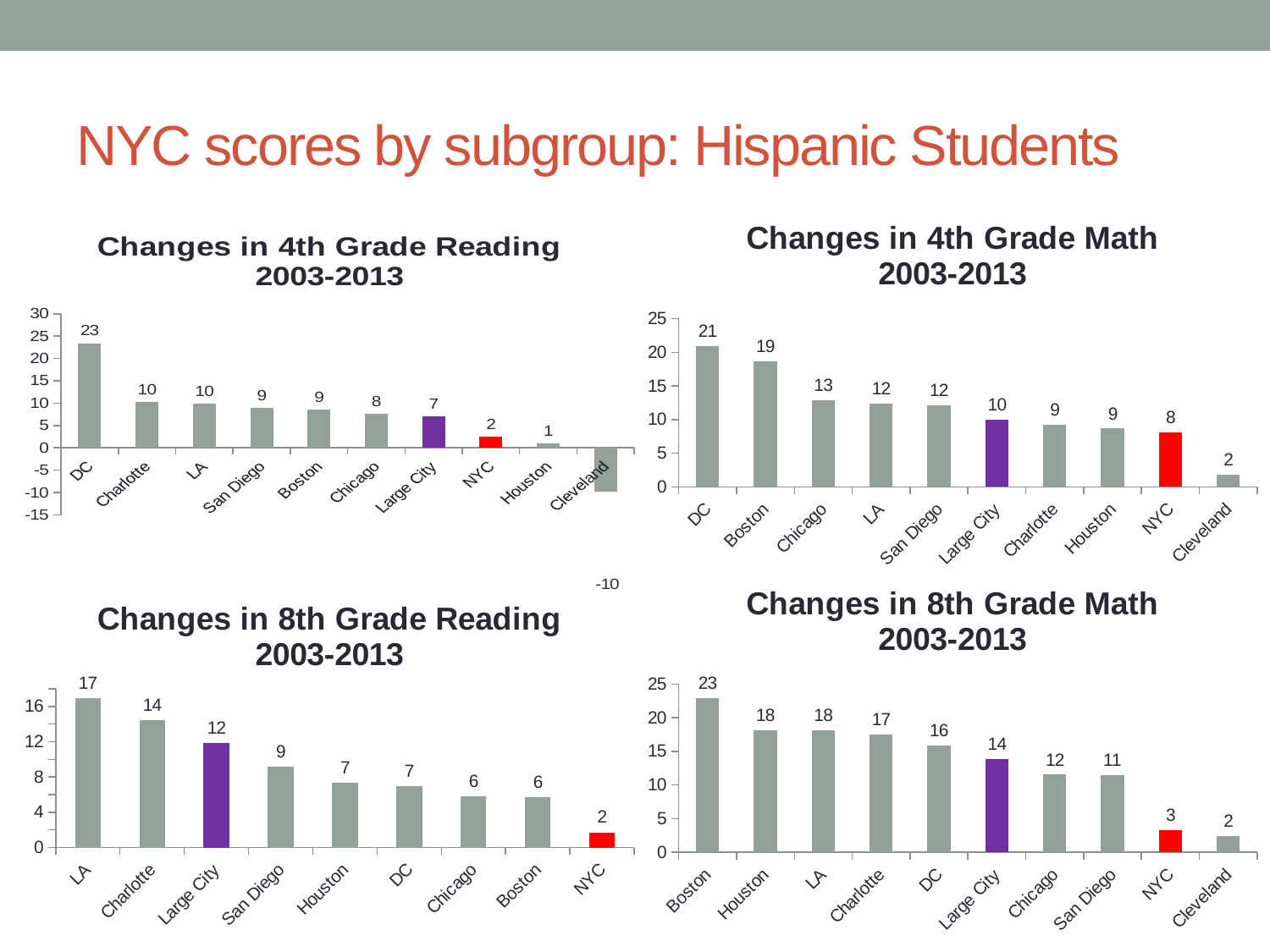
In the 'Changes in 4th Grade Reading 2003-2013' chart, what is the value for NYC? 2 In the 'Changes in 4th Grade Reading 2003-2013' chart, what is the value for DC? 23 What type of chart is 'Changes in 8th Grade Math 2003-2013'? Bar chart In the 'Changes in 8th Grade Reading 2003-2013' chart, how many cities are shown? 9 In the 'Changes in 8th Grade Reading 2003-2013' chart, which is larger, Charlotte or San Diego? Charlotte In the 'Changes in 4th Grade Reading 2003-2013' chart, which city has the lowest value? Cleveland In the 'Changes in 8th Grade Math 2003-2013' chart, what is the difference between Large City and NYC? 11 In the 'Changes in 4th Grade Math 2003-2013' chart, which city has the highest value? DC In the 'Changes in 4th Grade Math 2003-2013' chart, what is the difference between Boston and NYC? 11 In the 'Changes in 4th Grade Math 2003-2013' chart, how many cities are shown? 10 In the 'Changes in 8th Grade Math 2003-2013' chart, what is the value for Boston? 23 In the 'Changes in 8th Grade Reading 2003-2013' chart, what is the value for Large City? 12